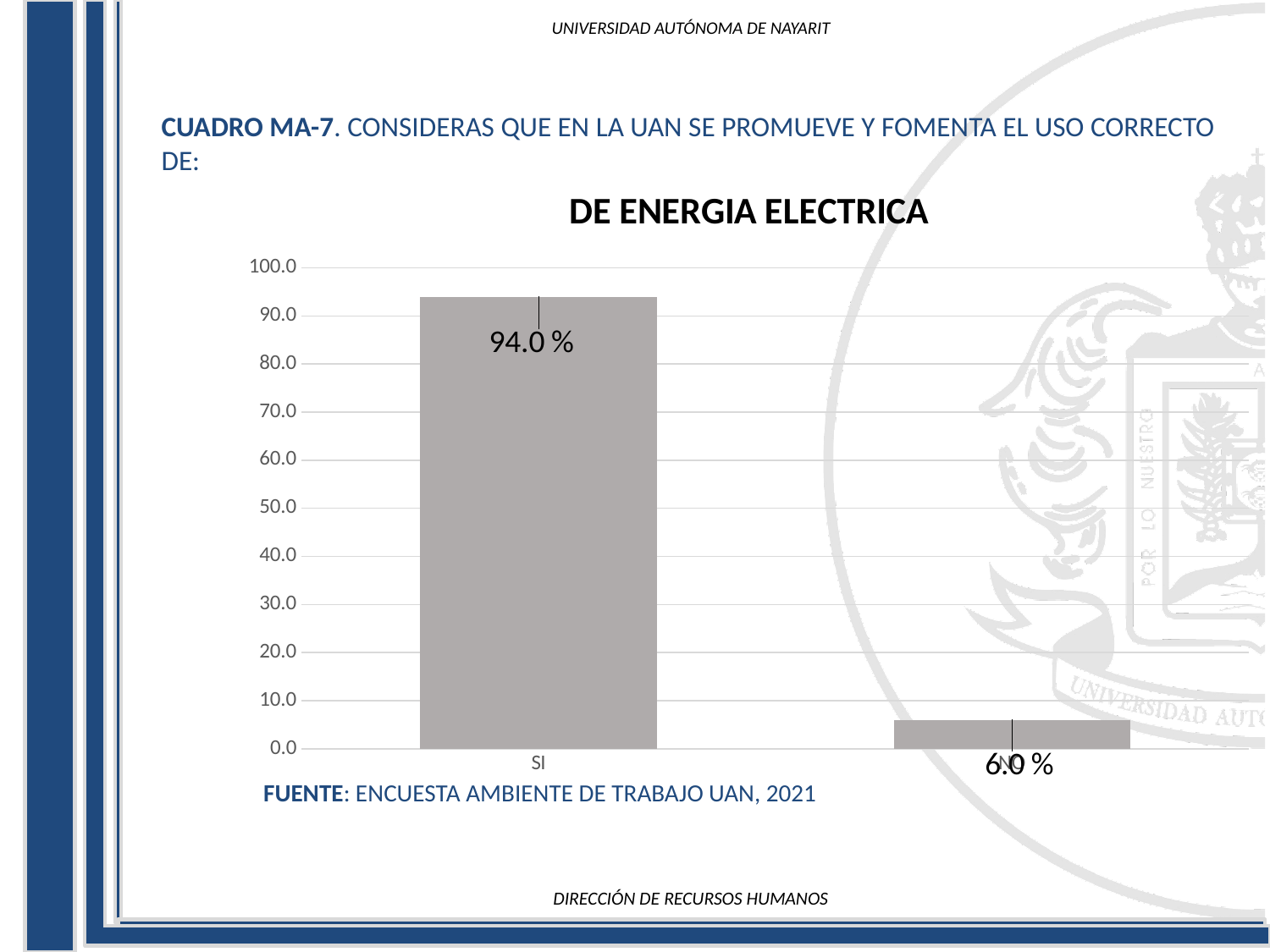
How many categories are shown in the chart? 2 Is the value for NO greater or less than 10.0? less Which category has the lowest value? NO Is the value for SI greater or less than 90.0? greater What kind of chart is shown on the slide? bar chart What is the difference between the values for SI and NO? 88.0 % What is the highest value shown on the vertical axis? 100.0 Which category has the highest value? SI What is the value for SI in the chart? 94.0 % What is the value for NO in the chart? 6.0 % What is the title of the chart? DE ENERGIA ELECTRICA Which is larger, the value for SI or the value for NO? SI